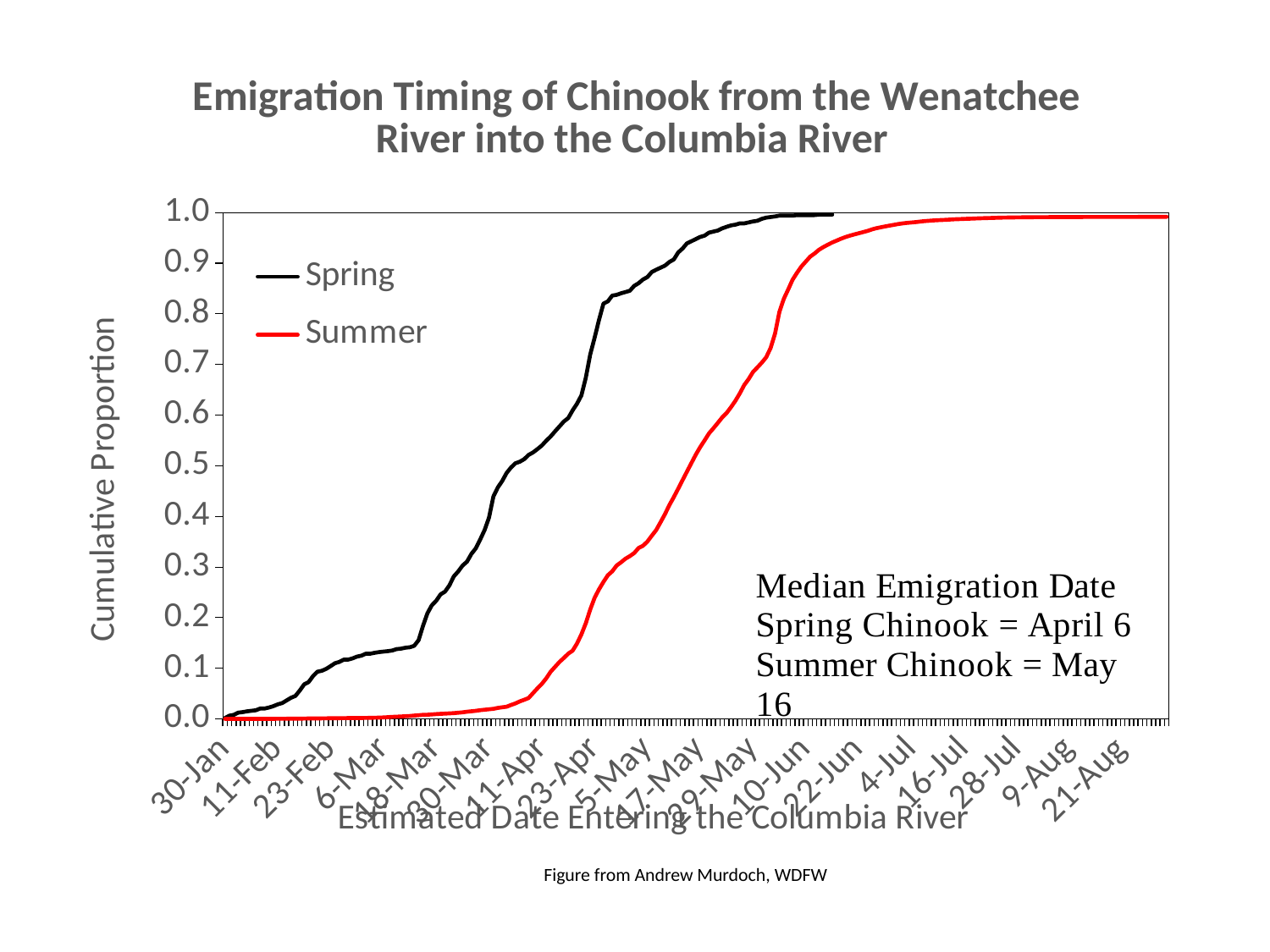
What are the two series named in the legend? Spring and Summer Do the cumulative proportion values rise or fall along the x axis? Rise At 5-May, which series has the higher cumulative proportion, Spring or Summer? Spring How many series does the legend list? 2 What type of chart is shown on the slide? Line chart Which series reaches a cumulative proportion of 0.5 earlier in the year, Spring or Summer? Spring Which series is drawn with the red line? Summer Is the Spring cumulative proportion at 23-Apr greater or less than 0.5? greater Is the Spring cumulative proportion at 18-Mar greater or less than 0.3? less According to the text on the chart, what is the median emigration date for Summer Chinook? May 16 Is the Summer cumulative proportion at 23-Apr greater or less than 0.5? less According to the text on the chart, what is the median emigration date for Spring Chinook? April 6